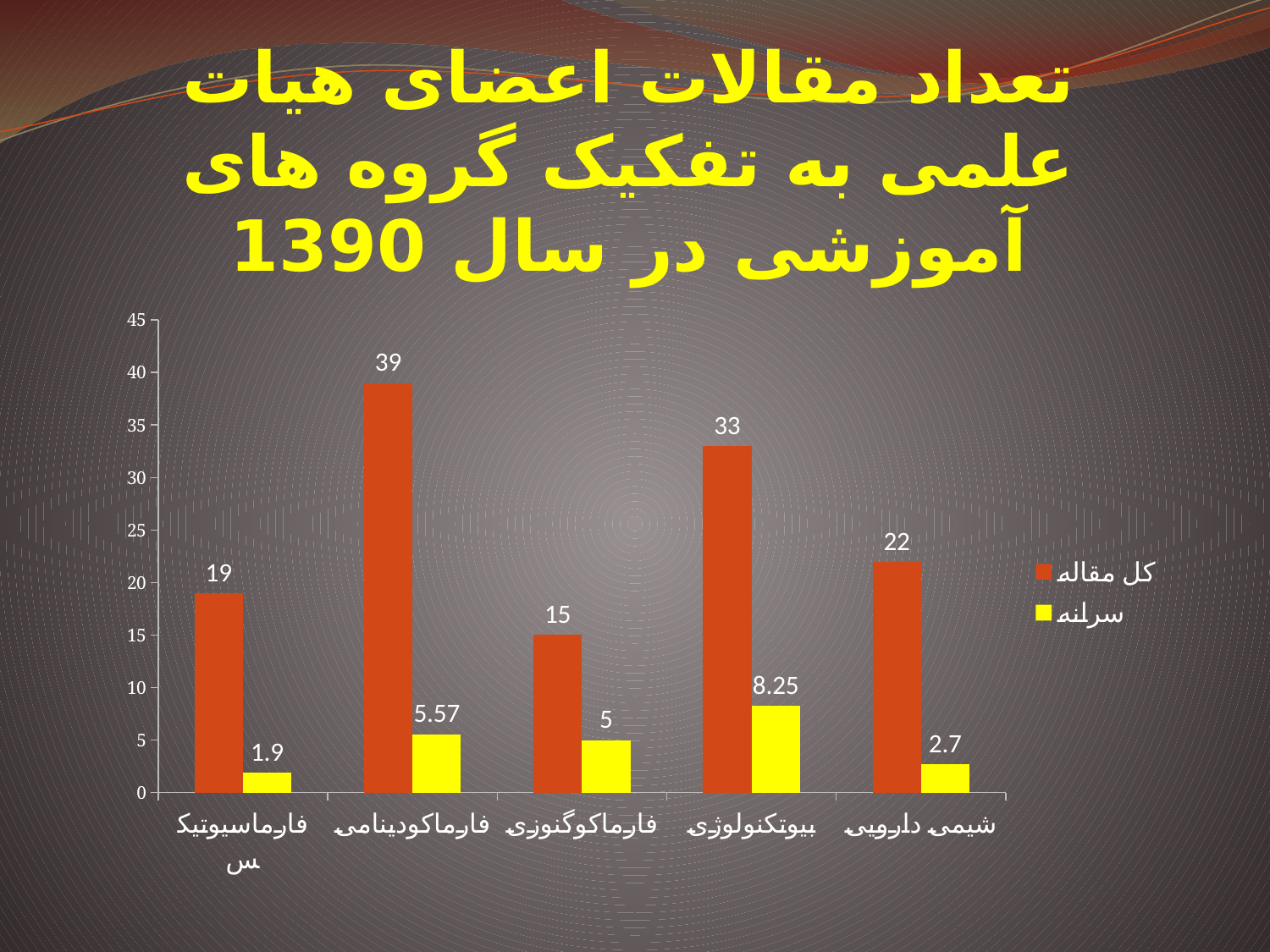
How many series does the legend list? 2 What is the value of سرانه for فارماسیوتیکس? 1.9 What is the value of کل مقاله for فارماکودینامی? 39 What kind of chart is shown on the slide? bar chart Which colour represents the سرانه series? yellow Which is larger: the کل مقاله value for بیوتکنولوژی or for شیمی دارویی? بیوتکنولوژی What is the difference between the کل مقاله values for فارماکودینامی and فارماکوگنوزی? 24 What is the value of سرانه for بیوتکنولوژی? 8.25 Which category has the highest value for کل مقاله? فارماکودینامی Which category has the lowest value for سرانه? فارماسیوتیکس How many categories are shown on the x axis? 5 Is the کل مقاله value for شیمی دارویی greater or less than 25? less